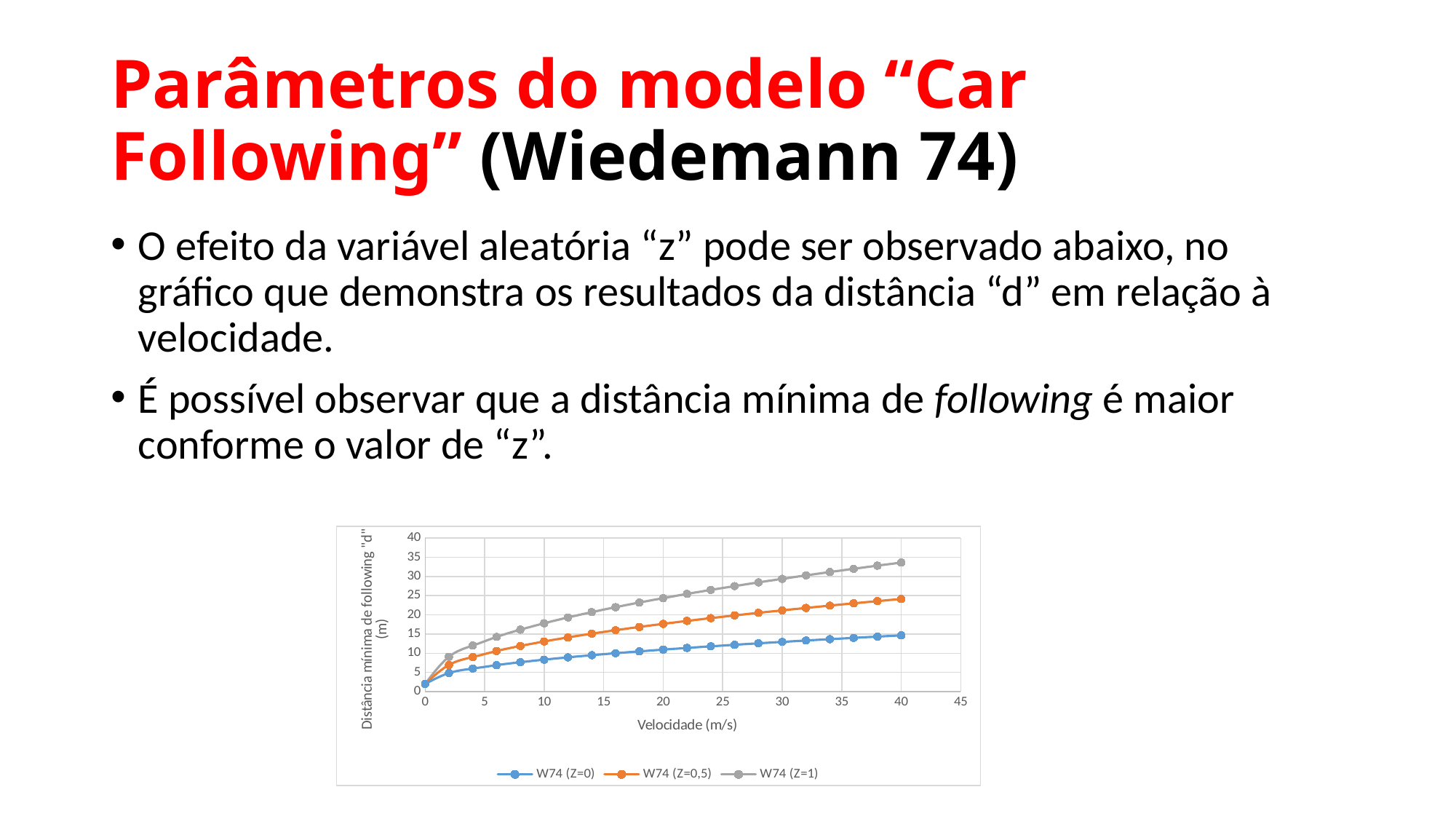
Which series has the lowest distance at a velocity of 40 m/s? W74 (Z=0) What kind of chart is shown on the slide? line chart How many series does the chart legend list? 3 What is the label of the x axis of the chart? Velocidade (m/s) Is the value for W74 (Z=1) at 40 m/s greater or less than 30? greater Is the value for W74 (Z=0) at 10 m/s greater or less than 10? less Is the value for W74 (Z=0) at 40 m/s greater or less than 20? less Do the values of the W74 (Z=1) series rise or fall as velocity increases? rise At 20 m/s, which is larger: the value for W74 (Z=0,5) or the value for W74 (Z=0)? W74 (Z=0,5) Which series has the highest distance at a velocity of 40 m/s? W74 (Z=1)